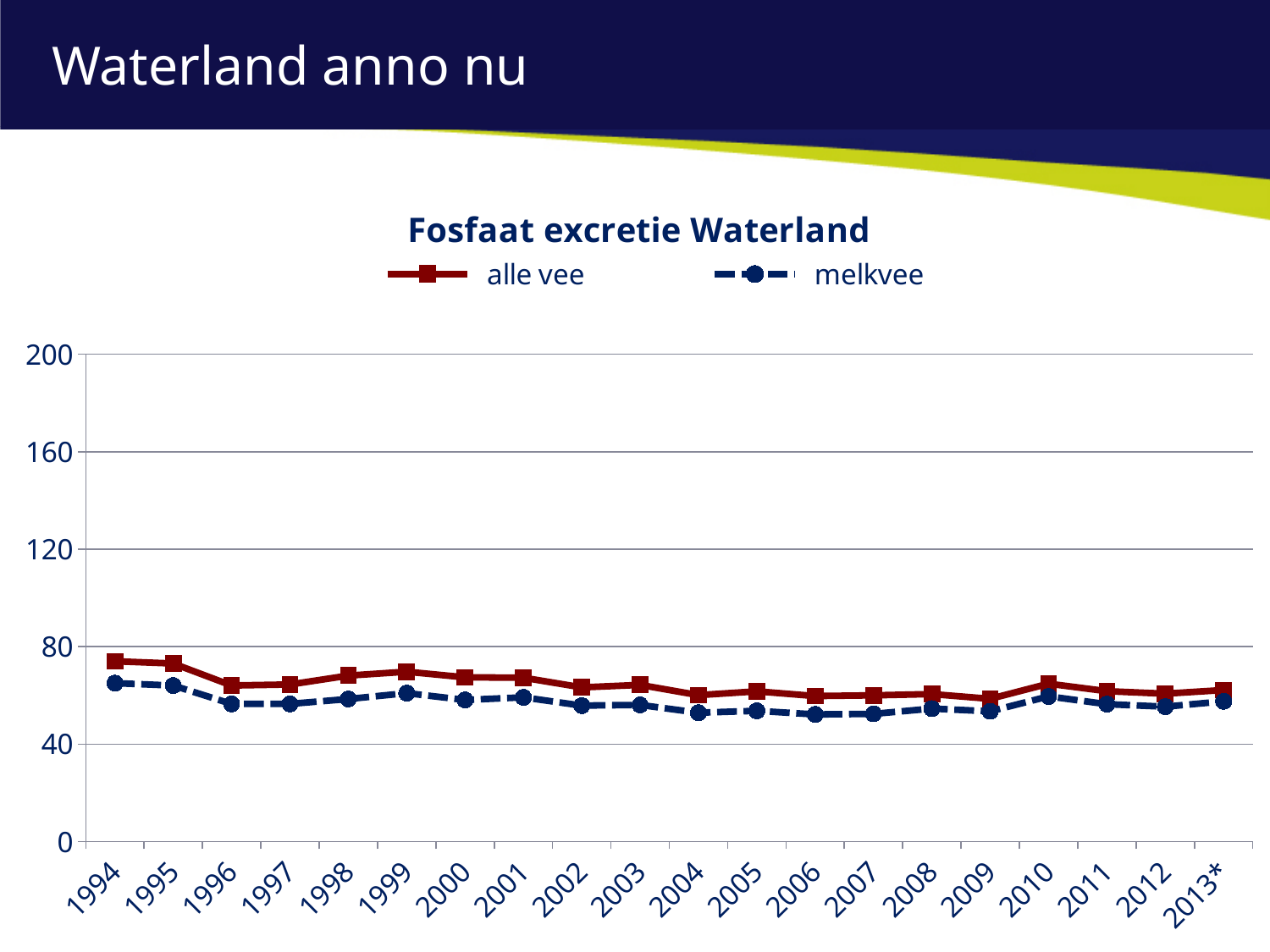
What are the two series named in the legend? alle vee and melkvee For melkvee, which year has the higher value, 1994 or 2006? 1994 How many series does the legend list? 2 Overall, does the alle vee line rise or fall from 1994 to 2013*? fall Which series has the higher value in 1994, alle vee or melkvee? alle vee Is the value for alle vee in 1994 greater or less than 80? less What kind of chart is shown on the slide? line chart Is the value for alle vee in 1999 greater or less than 120? less For alle vee, which year has the higher value, 1994 or 2013*? 1994 How many years are shown along the x axis? 20 Is the value for melkvee in 2006 greater or less than 40? greater What is the title of the chart? Fosfaat excretie Waterland